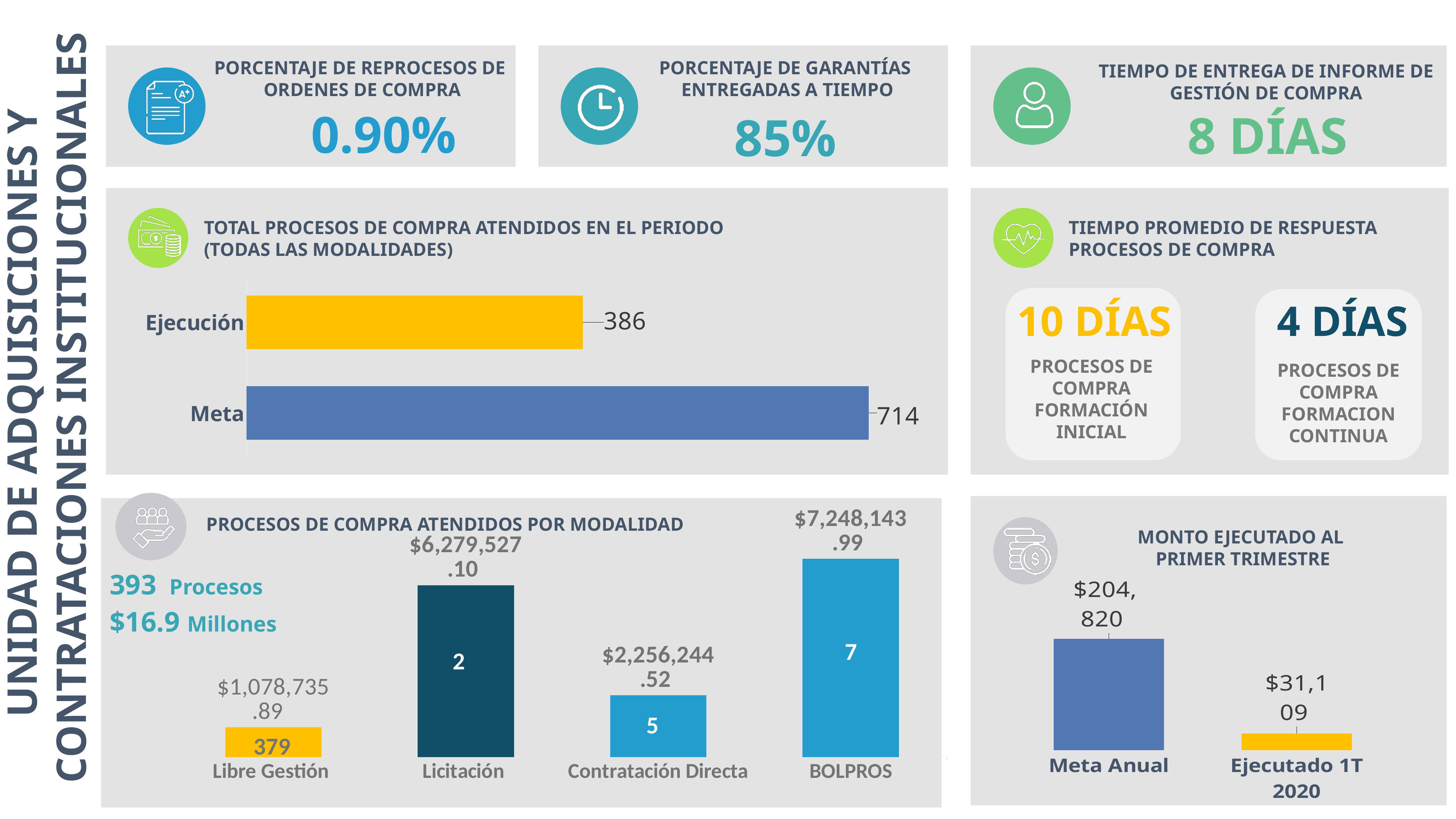
In the chart 'PROCESOS DE COMPRA ATENDIDOS POR MODALIDAD', what amount is labelled above the Libre Gestión bar? $1,078,735.89 In the chart 'MONTO EJECUTADO AL PRIMER TRIMESTRE', what is the value for Meta Anual? $204,820 How many modalities are shown in the chart 'PROCESOS DE COMPRA ATENDIDOS POR MODALIDAD'? 4 In the chart 'TOTAL PROCESOS DE COMPRA ATENDIDOS EN EL PERIODO', what is the difference between Meta and Ejecución? 328 What kind of chart is 'TOTAL PROCESOS DE COMPRA ATENDIDOS EN EL PERIODO'? Bar chart In the chart 'PROCESOS DE COMPRA ATENDIDOS POR MODALIDAD', what amount is labelled above the BOLPROS bar? $7,248,143.99 In the chart 'TOTAL PROCESOS DE COMPRA ATENDIDOS EN EL PERIODO', what is the value for Ejecución? 386 In the chart 'MONTO EJECUTADO AL PRIMER TRIMESTRE', which is larger, Meta Anual or Ejecutado 1T 2020? Meta Anual In the chart 'TOTAL PROCESOS DE COMPRA ATENDIDOS EN EL PERIODO', what is the value for Meta? 714 In the chart 'PROCESOS DE COMPRA ATENDIDOS POR MODALIDAD', which modality has the tallest bar? BOLPROS In the chart 'PROCESOS DE COMPRA ATENDIDOS POR MODALIDAD', what number is printed inside the Licitación bar? 2 In the chart 'PROCESOS DE COMPRA ATENDIDOS POR MODALIDAD', which modality has the shortest bar? Libre Gestión